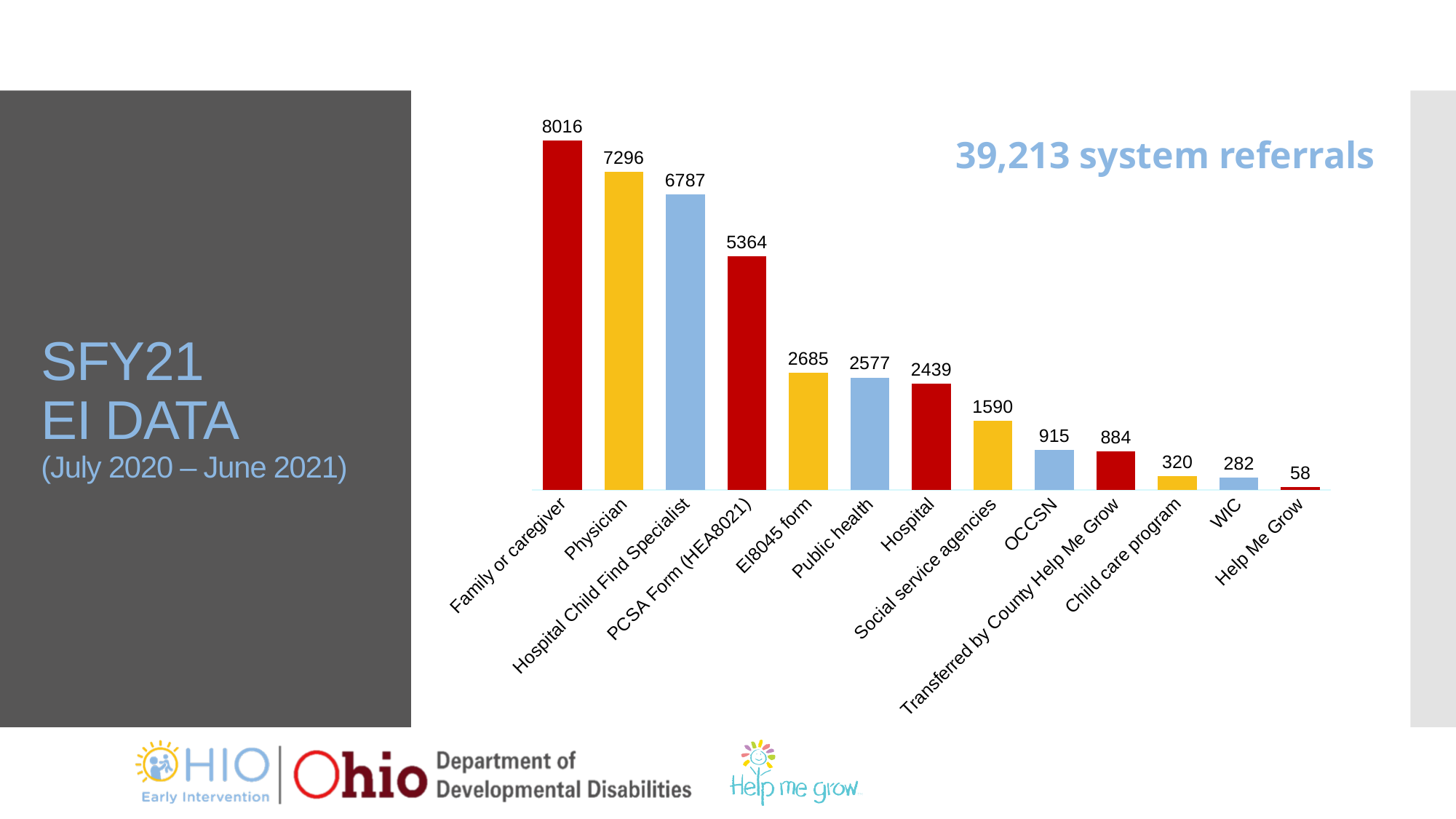
What is the value for Social service agencies? 1590 Which category has the lowest value? Help Me Grow What total number of system referrals is stated on the slide? 39,213 system referrals Which is larger, the value for OCCSN or the value for Public health? Public health What is the difference between the values for Family or caregiver and Physician? 720 How many categories are shown in the chart? 13 What is the value for Transferred by County Help Me Grow? 884 What is the difference between the values for Child care program and WIC? 38 What kind of chart is shown on the slide? Bar chart Which category has the highest value? Family or caregiver Which is larger, the value for Hospital Child Find Specialist or the value for PCSA Form (HEA8021)? Hospital Child Find Specialist What is the value for Physician? 7296